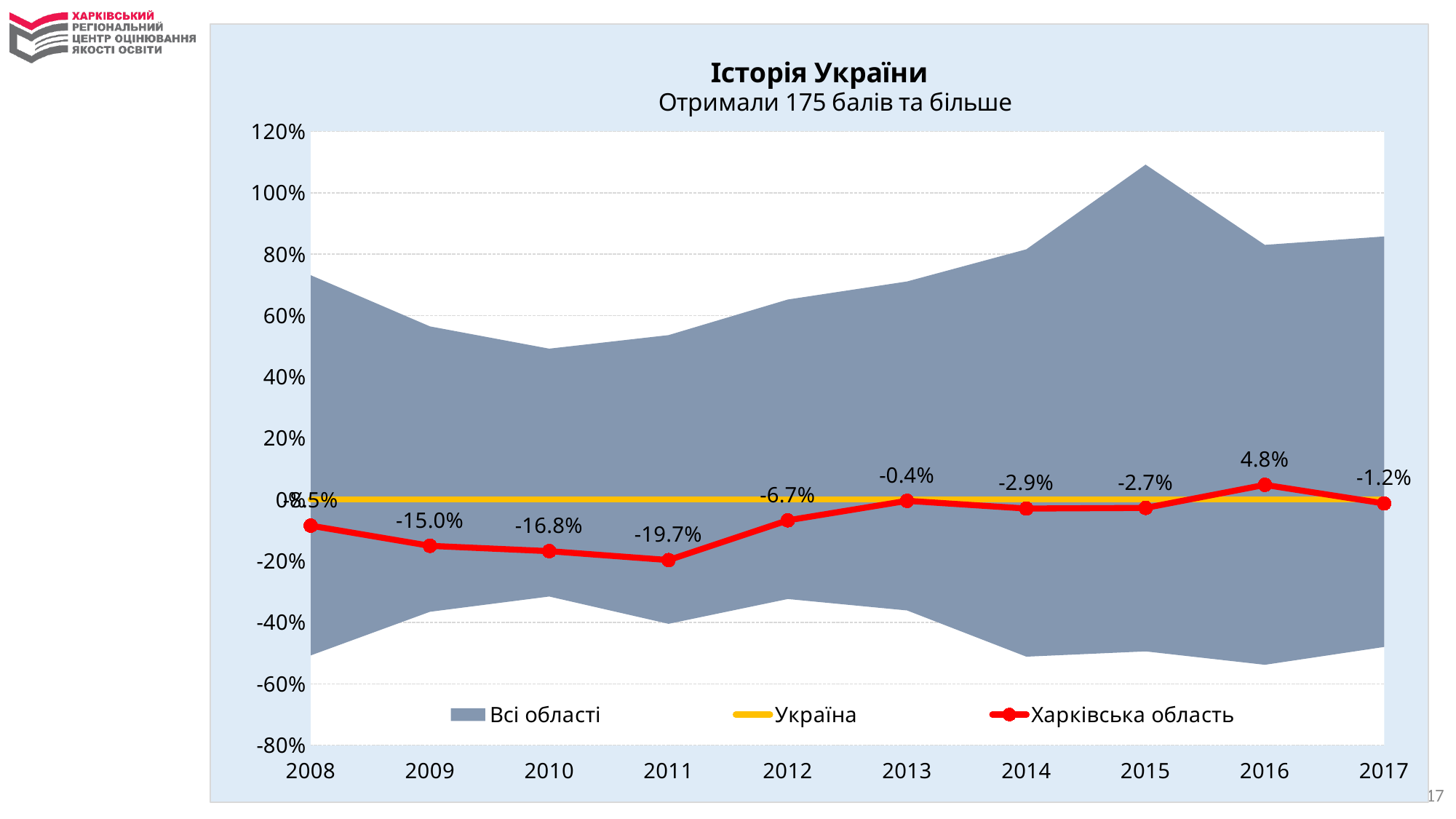
In which year is the Харківська область value highest? 2016 Does the Харківська область value rise or fall from 2009 to 2011? fall In which year is the Харківська область value lowest? 2011 Is the upper edge of the Всі області area in 2015 greater or less than 100%? greater What is the value for Харківська область in 2011? -19.7% What is the value for Харківська область in 2016? 4.8% What is the value for Харківська область in 2013? -0.4% How many years are shown on the x axis? 10 How many series does the legend list? 3 What is the difference between the Харківська область values in 2016 and 2017? 6.0 percentage points What is the subtitle of the chart? Отримали 175 балів та більше Which is larger for Харківська область: the value in 2009 or the value in 2012? 2012